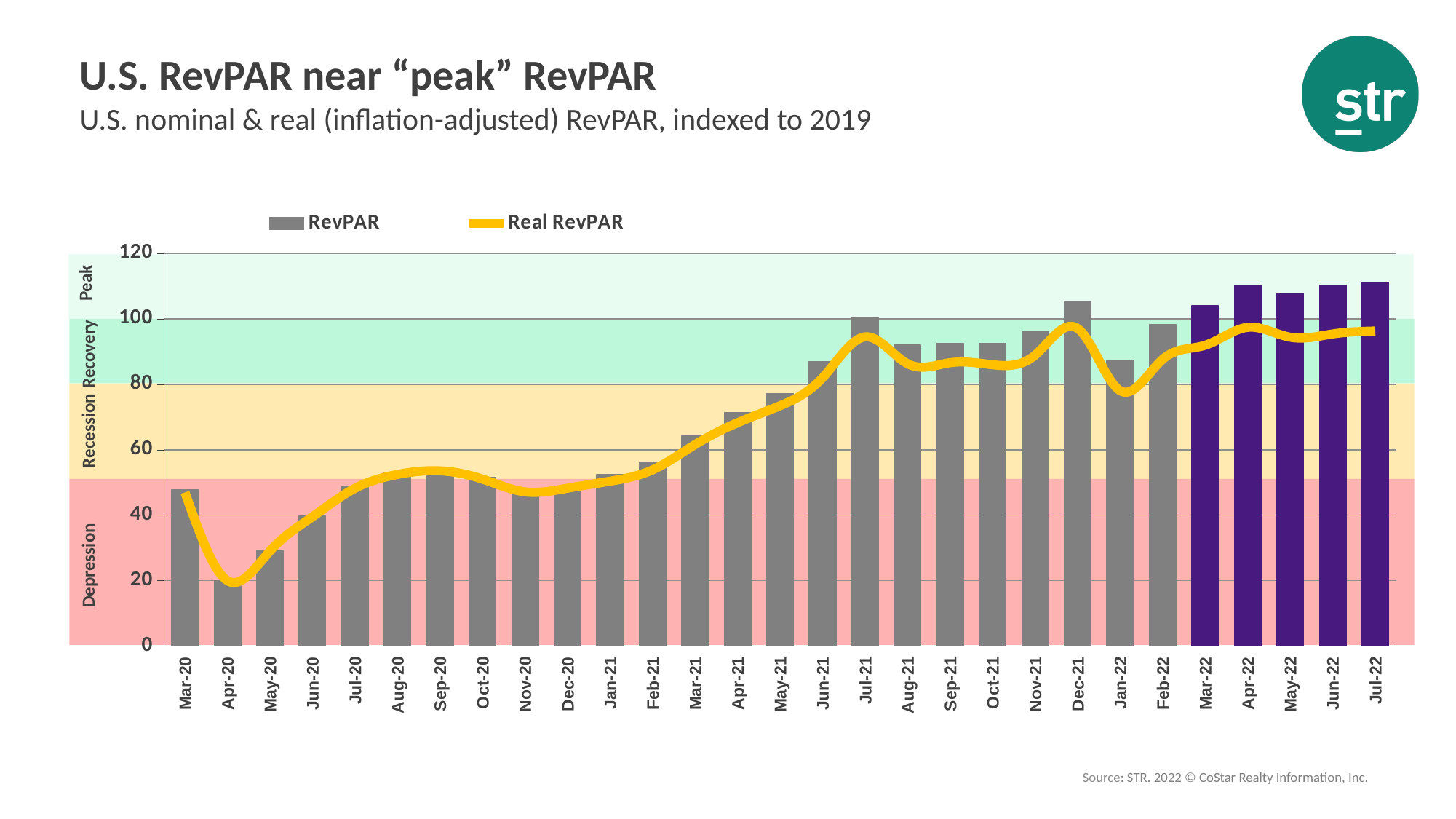
Does RevPAR rise or fall from Mar-20 to Apr-20? fall What is the title of the chart on the slide? U.S. RevPAR near "peak" RevPAR Is the RevPAR value for Jun-21 greater or less than 80? greater Which has the larger RevPAR bar, Jul-21 or Aug-21? Jul-21 Is the RevPAR value for Dec-21 greater or less than 100? greater Which month has the lowest RevPAR bar? Apr-20 How many series does the legend list? 2 How many months are plotted along the x axis? 29 Is the RevPAR value for Jan-22 greater or less than 100? less Which has the larger RevPAR bar, Dec-21 or Jan-22? Dec-21 What kind of chart is shown on the slide? bar chart with a line